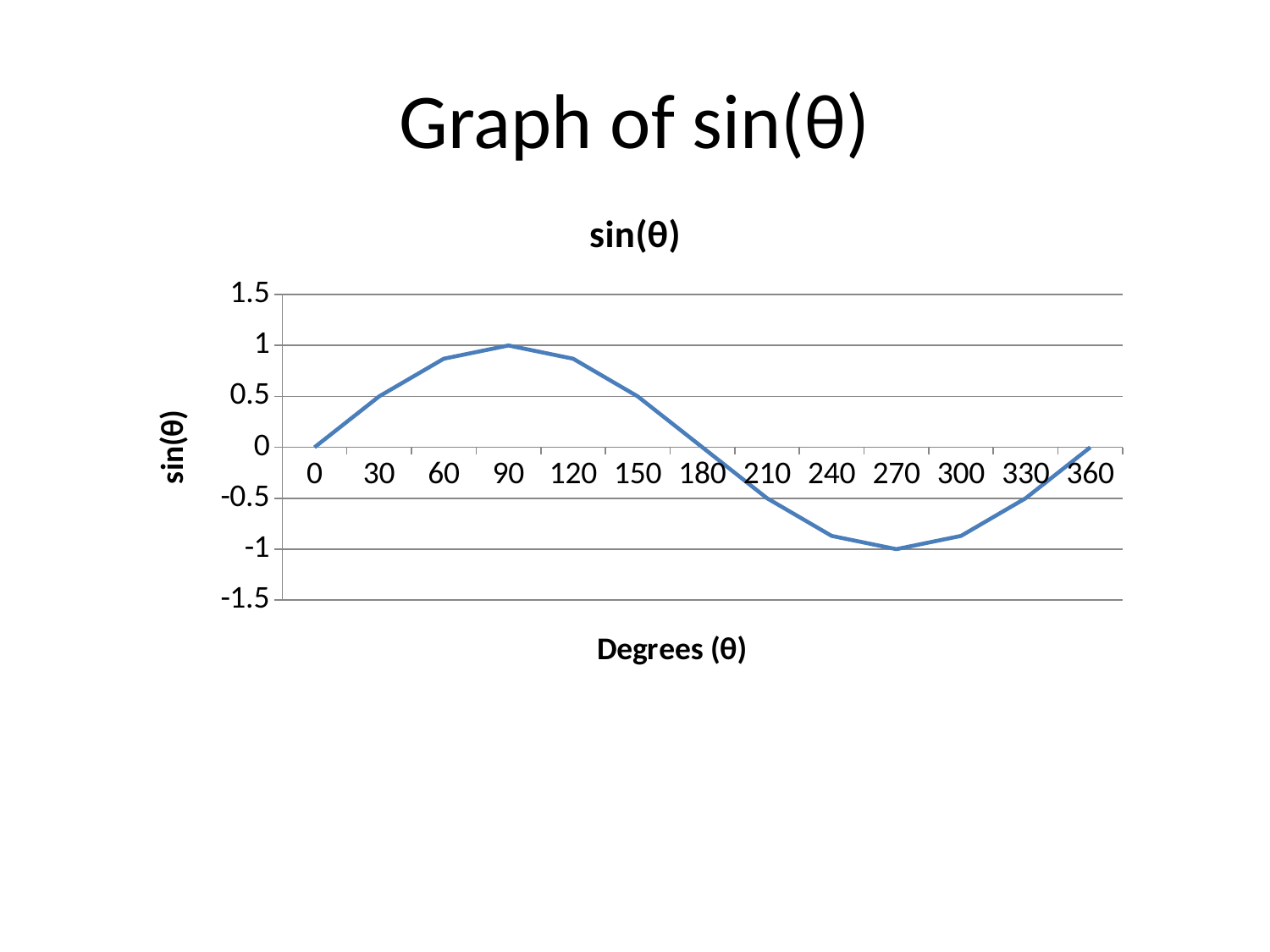
Does the line rise or fall between 90 and 270 degrees? fall At which degree value does the line reach its lowest point? 270 What is the label of the x axis? Degrees (θ) What is the value of sin(θ) at 90 degrees? 1 Is the value at 240 degrees greater or less than -0.5? less How many data points are plotted on the line? 13 Is the value at 60 degrees greater or less than 0.5? greater What kind of chart is shown on the slide? line chart What is the title of the chart? sin(θ) What is the value of sin(θ) at 270 degrees? -1 At which degree value does the line reach its highest point? 90 What is the value of sin(θ) at 180 degrees? 0